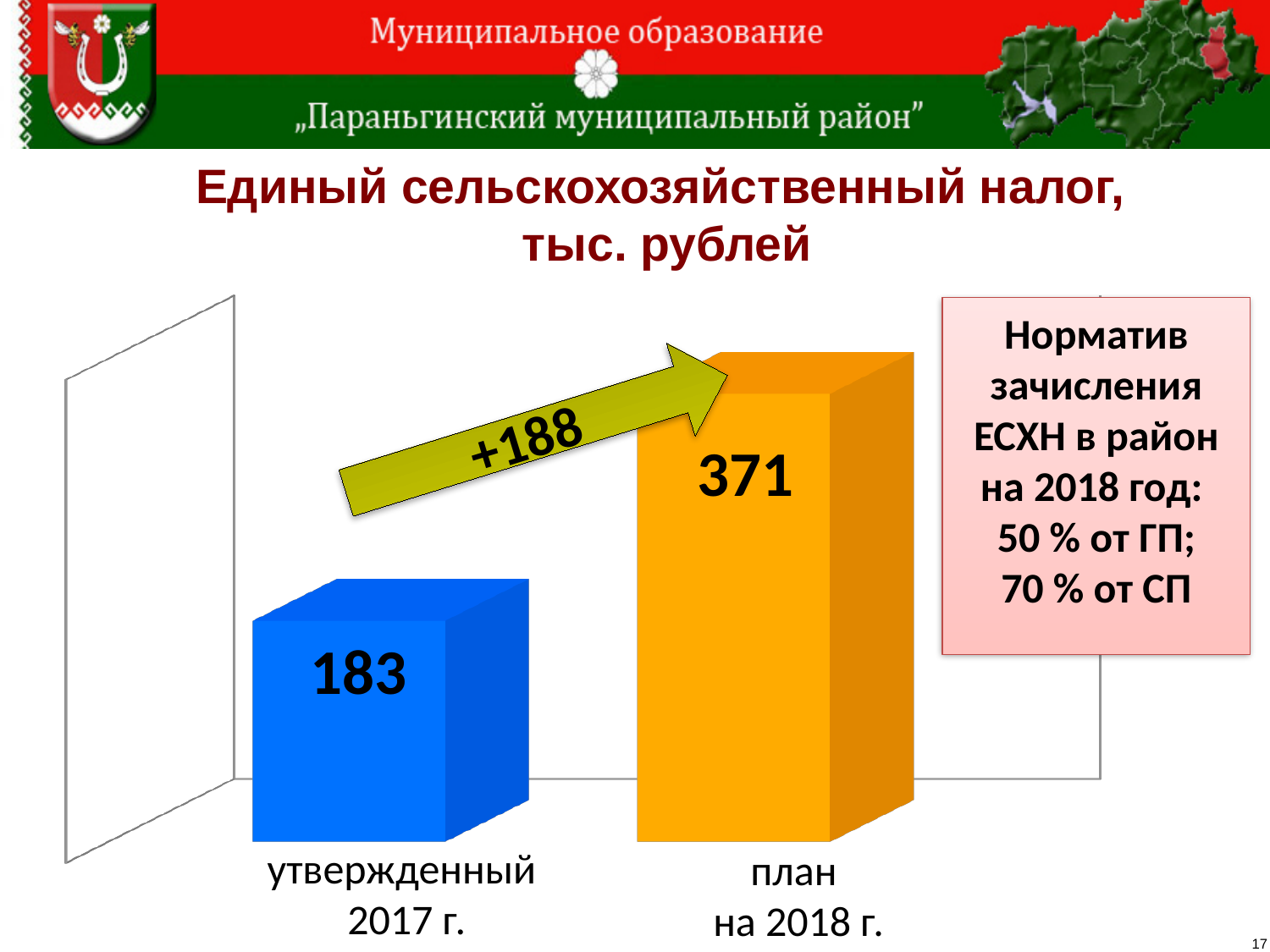
What is the value for 'план на 2018 г.'? 371 Do the values rise or fall from 'утвержденный 2017 г.' to 'план на 2018 г.'? rise What colour is the bar for 'план на 2018 г.'? orange What kind of chart is shown on the slide? bar chart What is the title of the chart? Единый сельскохозяйственный налог, тыс. рублей How many categories are shown in the chart? 2 What is the total of the two bars shown in the chart? 554 What is the value for 'утвержденный 2017 г.'? 183 What is the difference between the value for 'план на 2018 г.' and the value for 'утвержденный 2017 г.'? 188 Which category has the highest value? план на 2018 г. Which is larger: the value for 'утвержденный 2017 г.' or the value for 'план на 2018 г.'? план на 2018 г. Which category has the lowest value? утвержденный 2017 г.